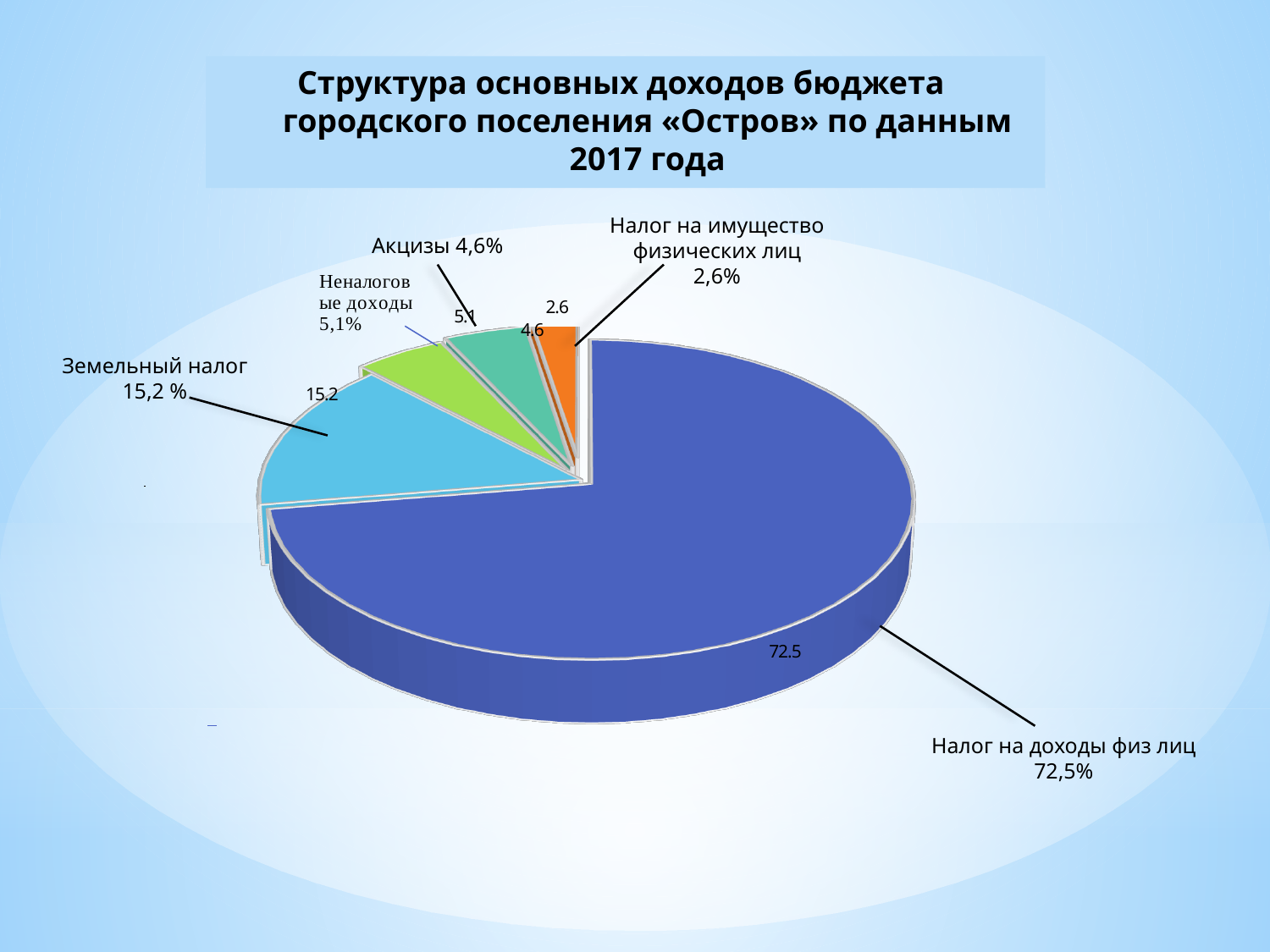
What is the share of Налог на доходы физ лиц in the pie chart? 72,5% What is the share of Неналоговые доходы in the pie chart? 5,1% Which is larger, the share of Неналоговые доходы or the share of Акцизы? Неналоговые доходы What kind of chart is shown on the slide? Pie chart How many slices does the pie chart have? 5 What is the share of Налог на имущество физических лиц in the pie chart? 2,6% What is the share of Акцизы in the pie chart? 4,6% What is the difference in percentage points between Налог на доходы физ лиц and Земельный налог? 57,3 What year does the chart title say the data is from? 2017 Which category has the smallest slice in the pie chart? Налог на имущество физических лиц Which category has the largest slice in the pie chart? Налог на доходы физ лиц What is the share of Земельный налог in the pie chart? 15,2%